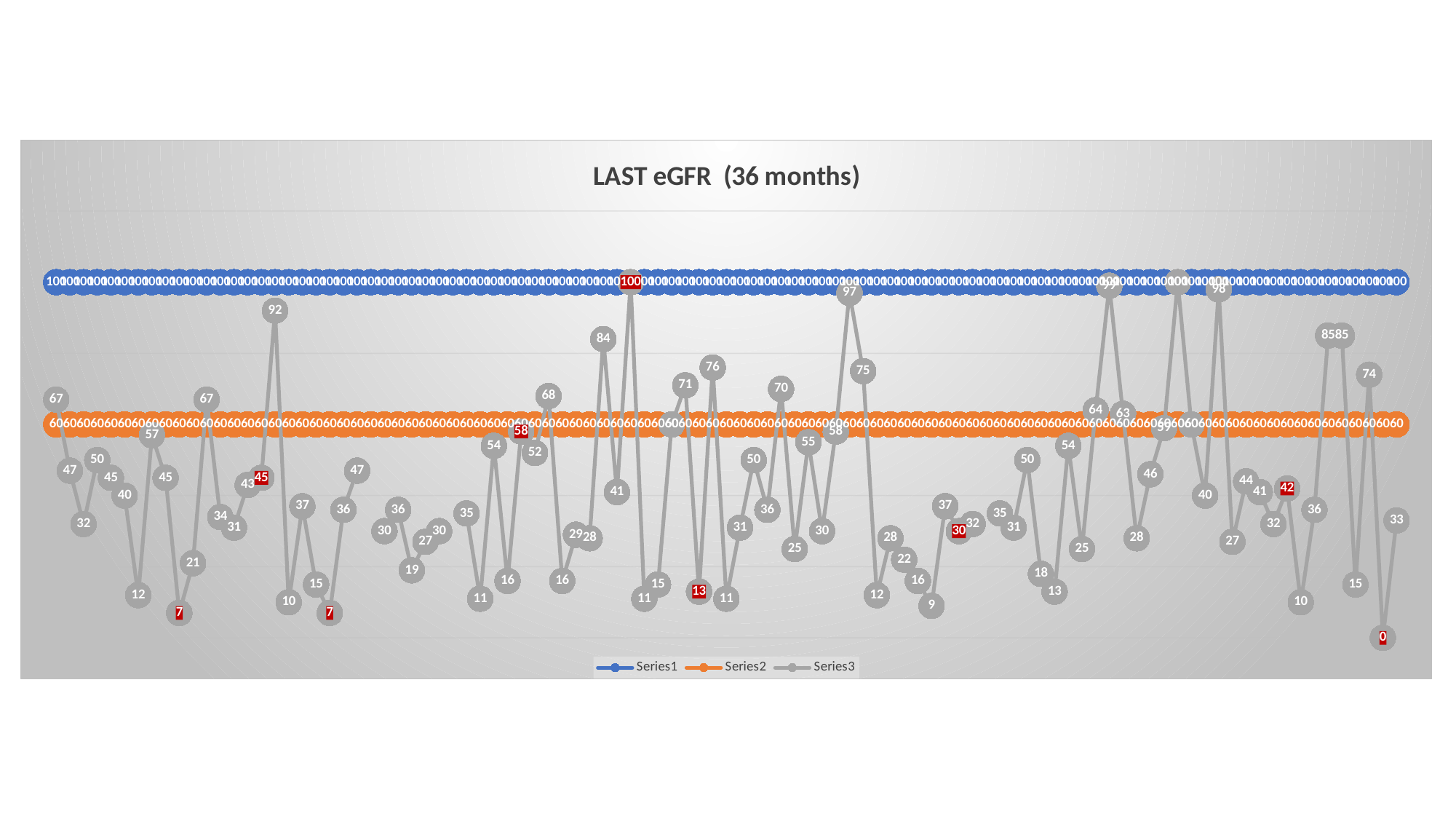
What constant value does Series1 hold across the chart? 100 Is the Series2 line greater or less than 100? less What is the highest value labelled on Series3? 100 What is the difference between the constant value of Series1 and the constant value of Series2? 40 What is the title of the chart? LAST eGFR (36 months) Which series is plotted higher on the chart, Series1 or Series2? Series1 What constant value does Series2 hold across the chart? 60 What is the lowest value labelled on Series3? 0 What colour is the Series2 line? orange How many series does the chart legend list? 3 What type of chart is shown on the slide? line chart